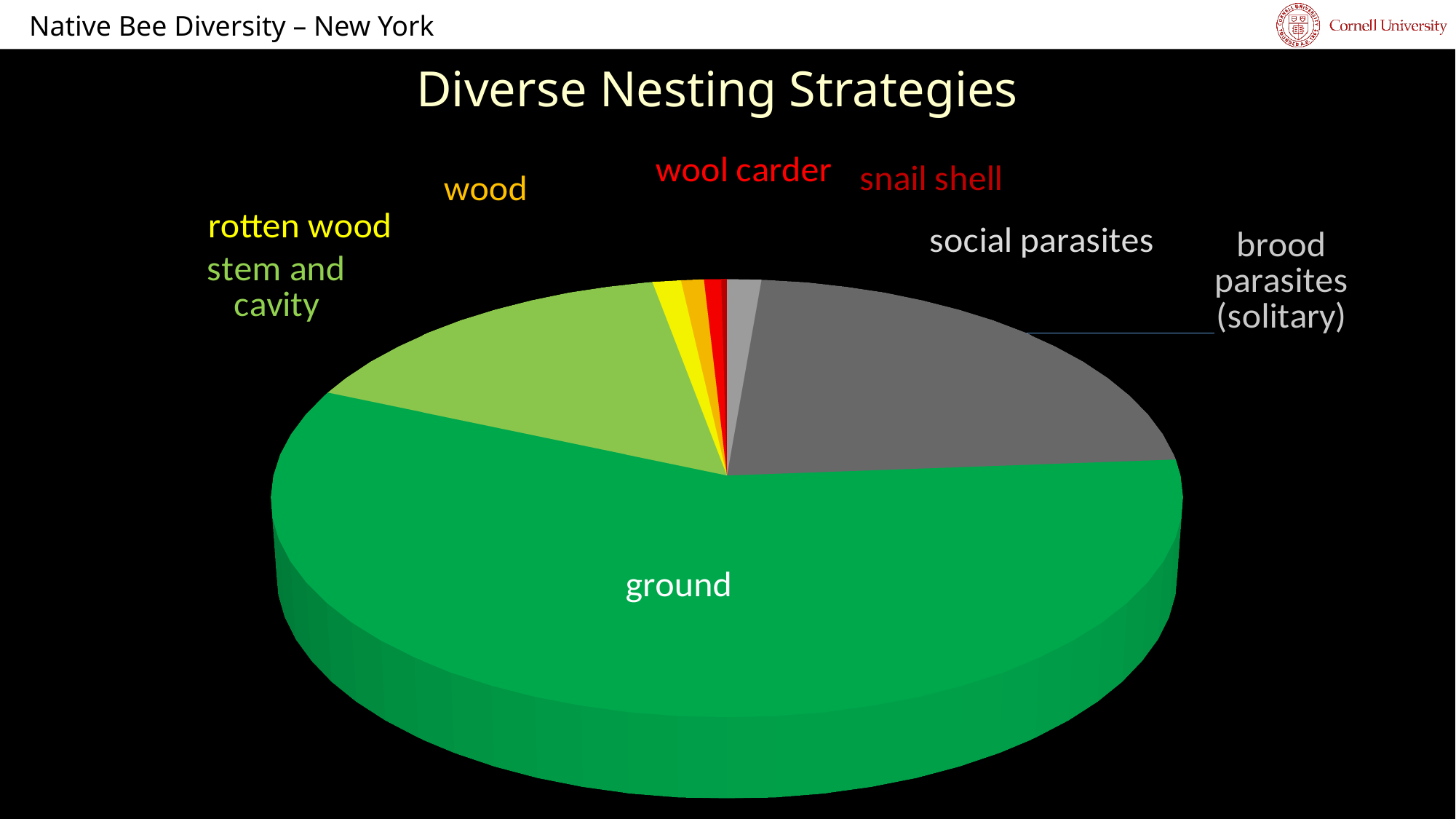
What is the title of the chart? Diverse Nesting Strategies What kind of chart is shown on the slide? pie chart Which nesting strategy has the largest slice of the pie? ground Which slice is larger, brood parasites (solitary) or stem and cavity? brood parasites (solitary) What colour is the ground slice of the pie chart? green Which slice is larger, stem and cavity or rotten wood? stem and cavity Which slice is larger, brood parasites (solitary) or social parasites? brood parasites (solitary) How many nesting strategy categories are labelled on the pie chart? 8